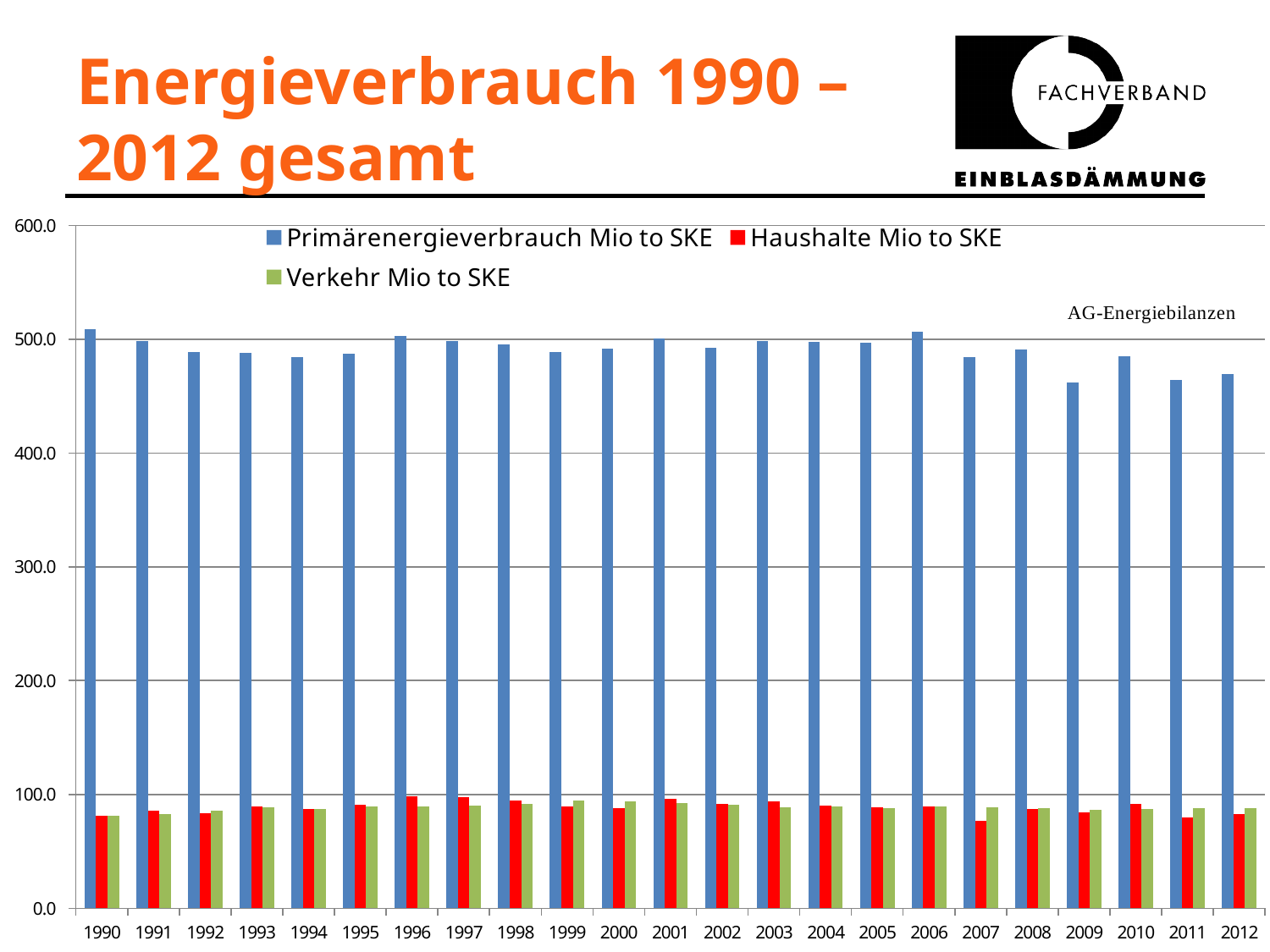
Is the value for Primärenergieverbrauch Mio to SKE in 1990 greater or less than 500.0? greater What kind of chart is shown on the slide? bar chart How many series does the legend list? 3 Is the value for Haushalte Mio to SKE in 2007 greater or less than 100.0? less What source is named on the chart? AG-Energiebilanzen Is the value for Verkehr Mio to SKE in 1999 greater or less than 100.0? less Does Primärenergieverbrauch Mio to SKE overall rise or fall from 2006 to 2012? fall Which is larger, Primärenergieverbrauch Mio to SKE in 1990 or in 2012? 1990 In 2007, which is larger, Haushalte Mio to SKE or Verkehr Mio to SKE? Verkehr Mio to SKE How many years are shown along the x axis? 23 Which is larger, Haushalte Mio to SKE in 1996 or in 2007? 1996